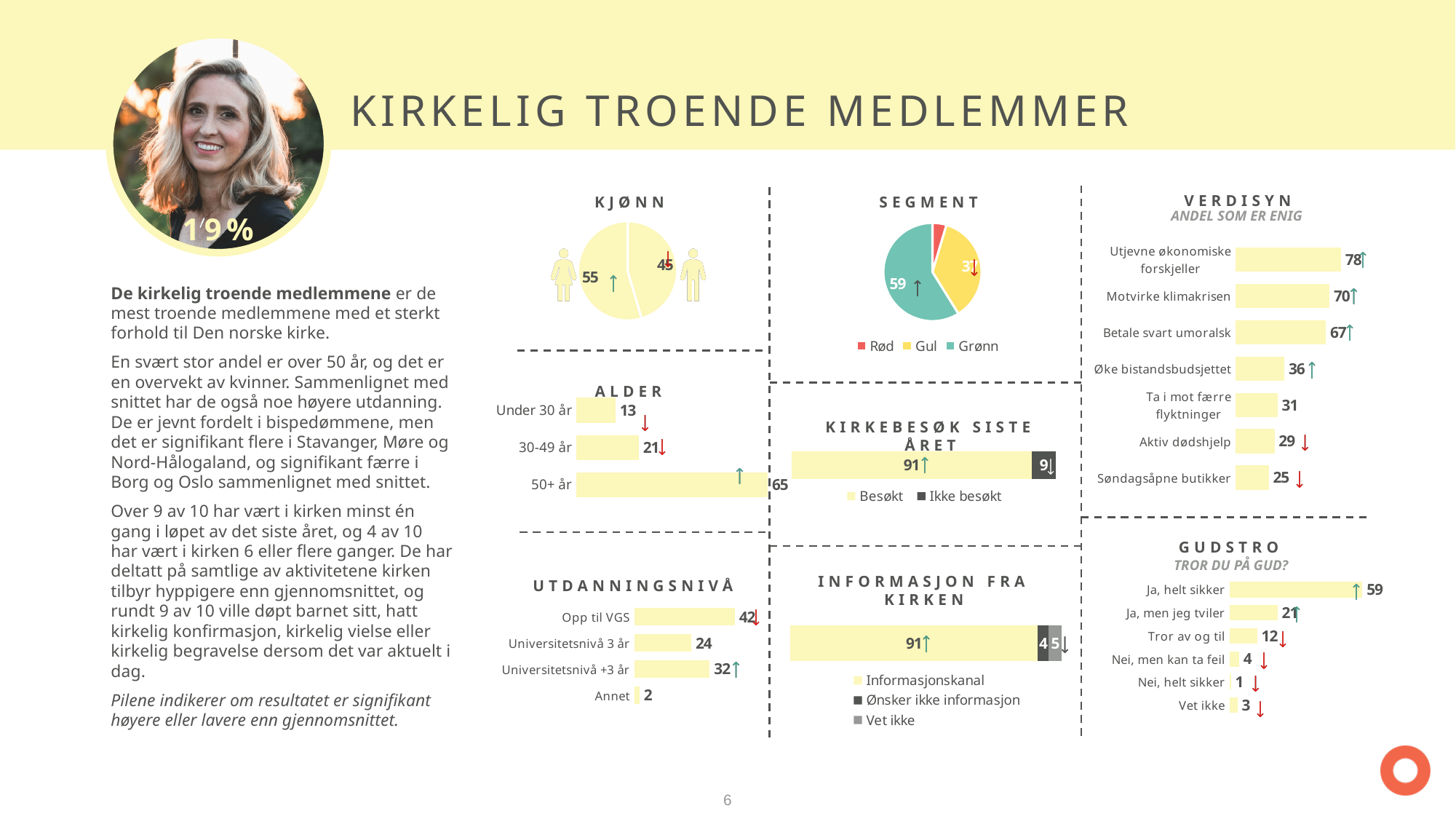
In the ALDER chart, which age group has the lowest value? Under 30 år In the GUDSTRO chart, what is the value for Nei, helt sikker? 1 In the UTDANNINGSNIVÅ chart, what is the value for Universitetsnivå 3 år? 24 In the ALDER chart, what is the difference between the values for 50+ år and 30-49 år? 44 In the VERDISYN chart, which statement has the lowest share agreeing? Søndagsåpne butikker In the VERDISYN chart, what is the value for Motvirke klimakrisen? 70 In the UTDANNINGSNIVÅ chart, which category has the highest value? Opp til VGS How many series does the legend of the INFORMASJON FRA KIRKEN chart list? 3 In the ALDER chart, what is the value for 50+ år? 65 In the GUDSTRO chart, which is larger, the value for Ja, men jeg tviler or the value for Tror av og til? Ja, men jeg tviler How many categories does the UTDANNINGSNIVÅ chart show? 4 In the KIRKEBESØK SISTE ÅRET chart, what is the value for Besøkt? 91